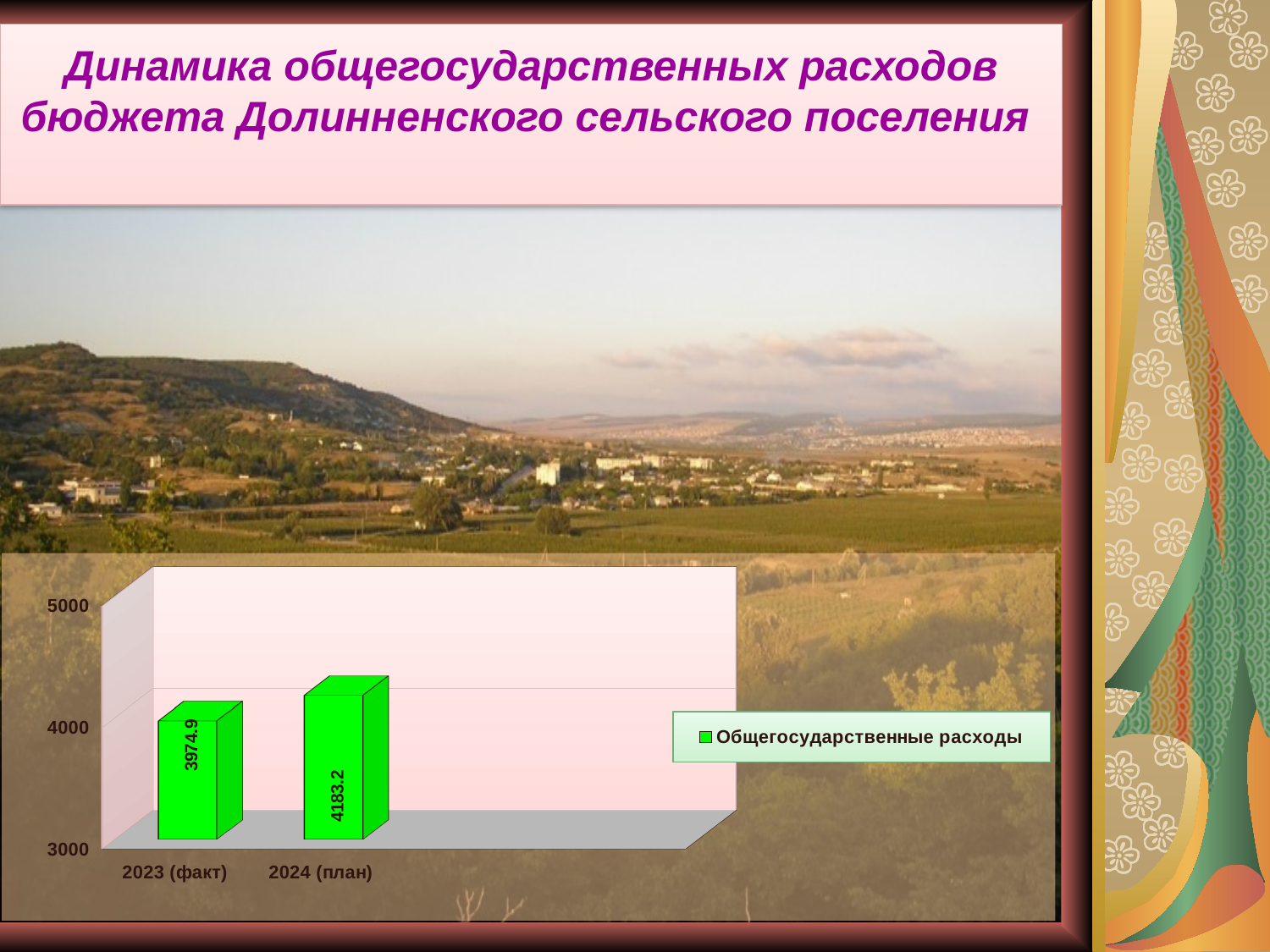
How many series does the legend list? 1 What is the name of the series listed in the legend? Общегосударственные расходы Is the value for 2023 (факт) greater or less than 4000? less Which is larger, the value for 2023 (факт) or the value for 2024 (план)? 2024 (план) What is the difference between the values for 2024 (план) and 2023 (факт)? 208.3 What is the value for 2023 (факт)? 3974.9 Is the value for 2024 (план) greater or less than 4000? greater How many categories are shown on the x axis? 2 Which category has the lowest value? 2023 (факт) What is the value for 2024 (план)? 4183.2 What kind of chart is shown on the slide? bar chart Which category has the highest value? 2024 (план)